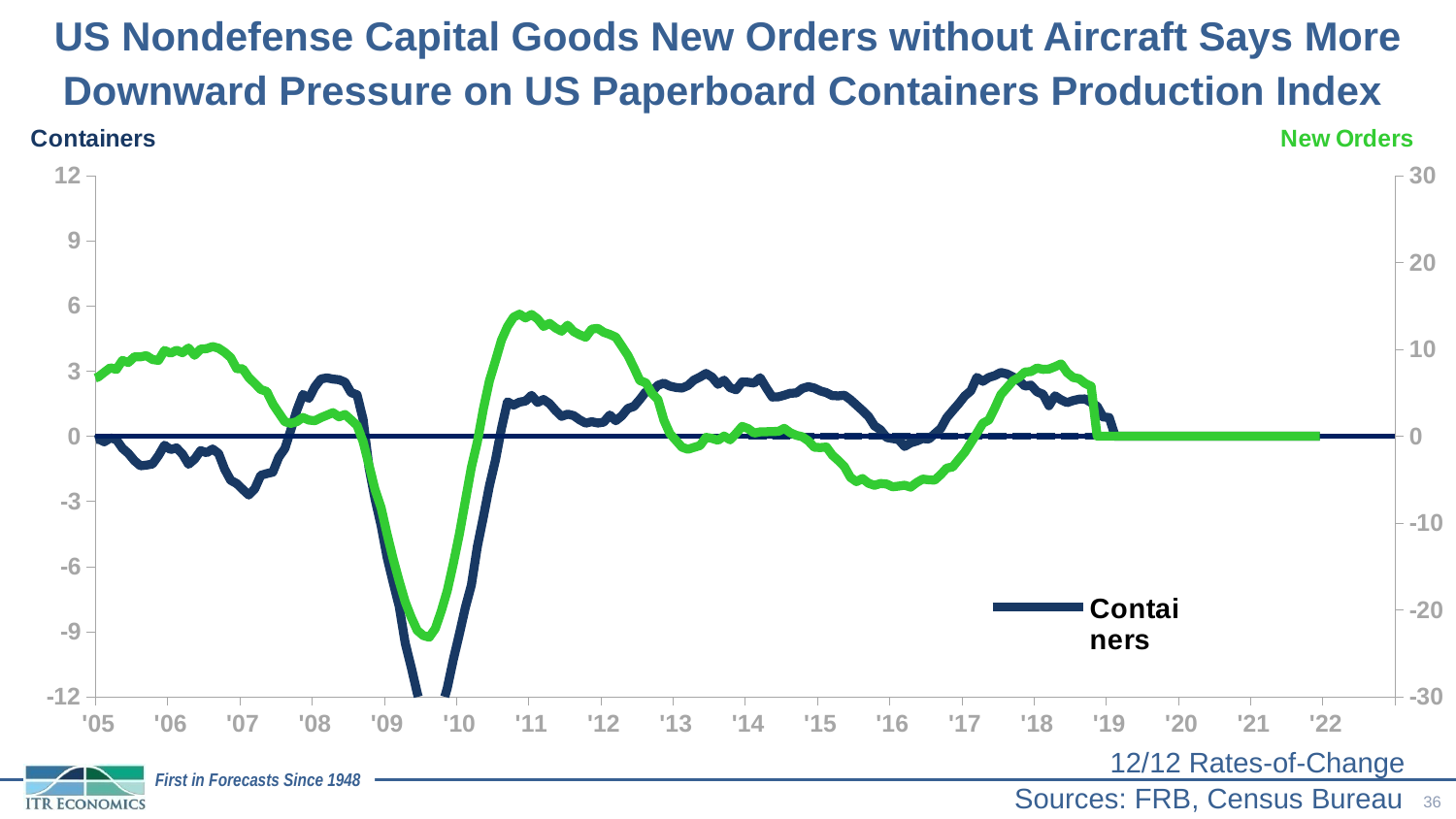
What kind of chart is shown on the slide? line chart Around which year does the New Orders line reach its lowest point? '09 Does the New Orders line rise or fall between '05 and '09? fall Does the Containers line rise or fall between '09 and '11? rise Is the Containers value around '07 greater or less than 0? less Is the peak of the New Orders line around '11 greater or less than 10 on the right axis? greater Is the lowest value of the New Orders line (around '09) greater or less than -20 on the right axis? less Which series is plotted in green? New Orders How many lines are plotted on the chart? 2 Around which year does the Containers line reach its lowest point? '09 What is the highest value shown on the right-hand axis? 30 Around which year does the New Orders line reach its highest point? '11